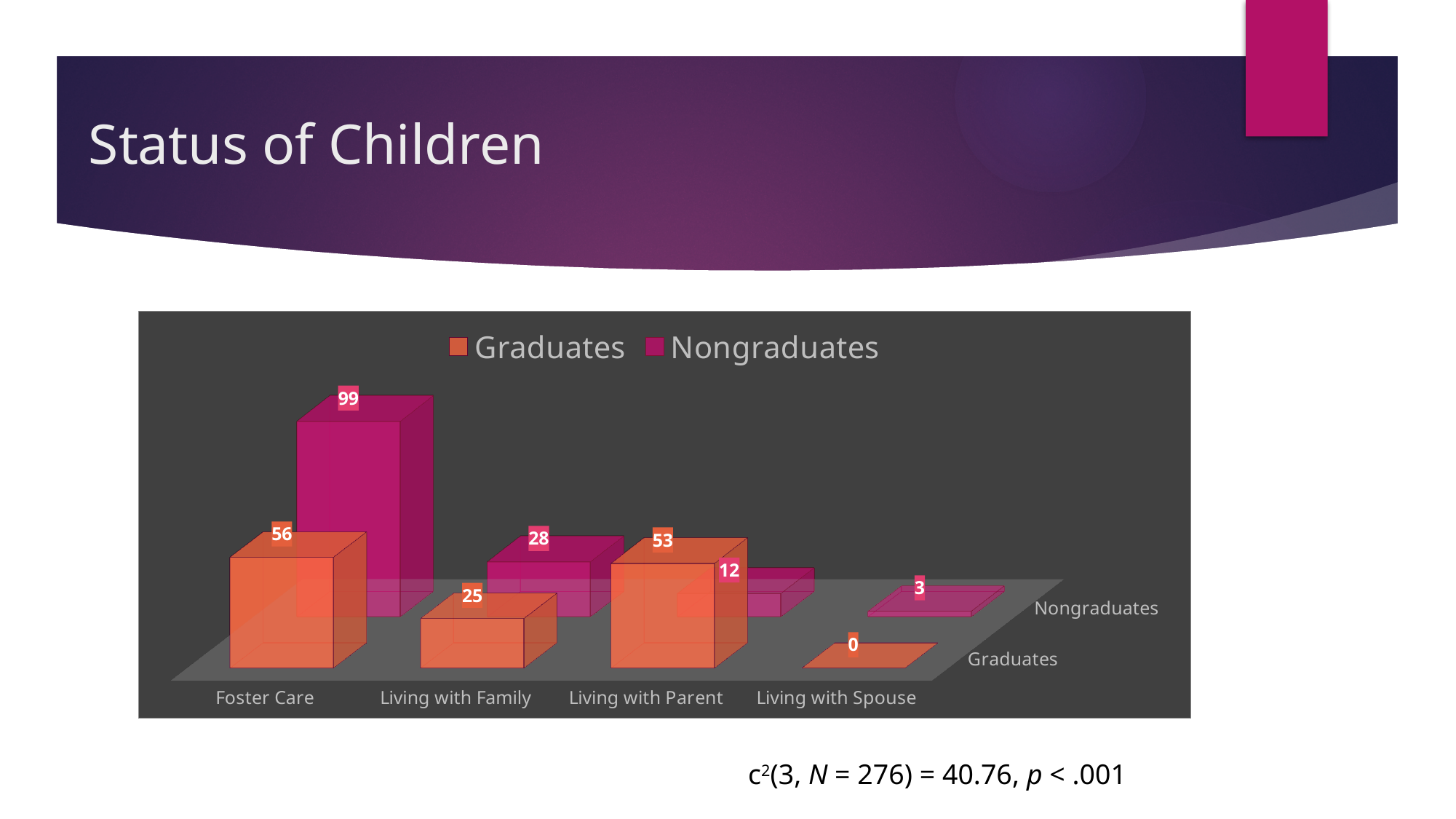
What is the value for Graduates in the Living with Family category? 25 What is the value for Nongraduates in the Foster Care category? 99 What is the value for Nongraduates in the Living with Parent category? 12 Which category has the highest Nongraduates value? Foster Care Which is larger for Living with Parent: Graduates or Nongraduates? Graduates What is the value for Graduates in the Living with Spouse category? 0 How many categories are shown on the x axis? 4 Which category has the lowest Graduates value? Living with Spouse What is the difference between the Nongraduates and Graduates values for Foster Care? 43 What kind of chart is shown on the slide? Bar chart What is the value for Graduates in the Foster Care category? 56 How many series does the legend list? 2